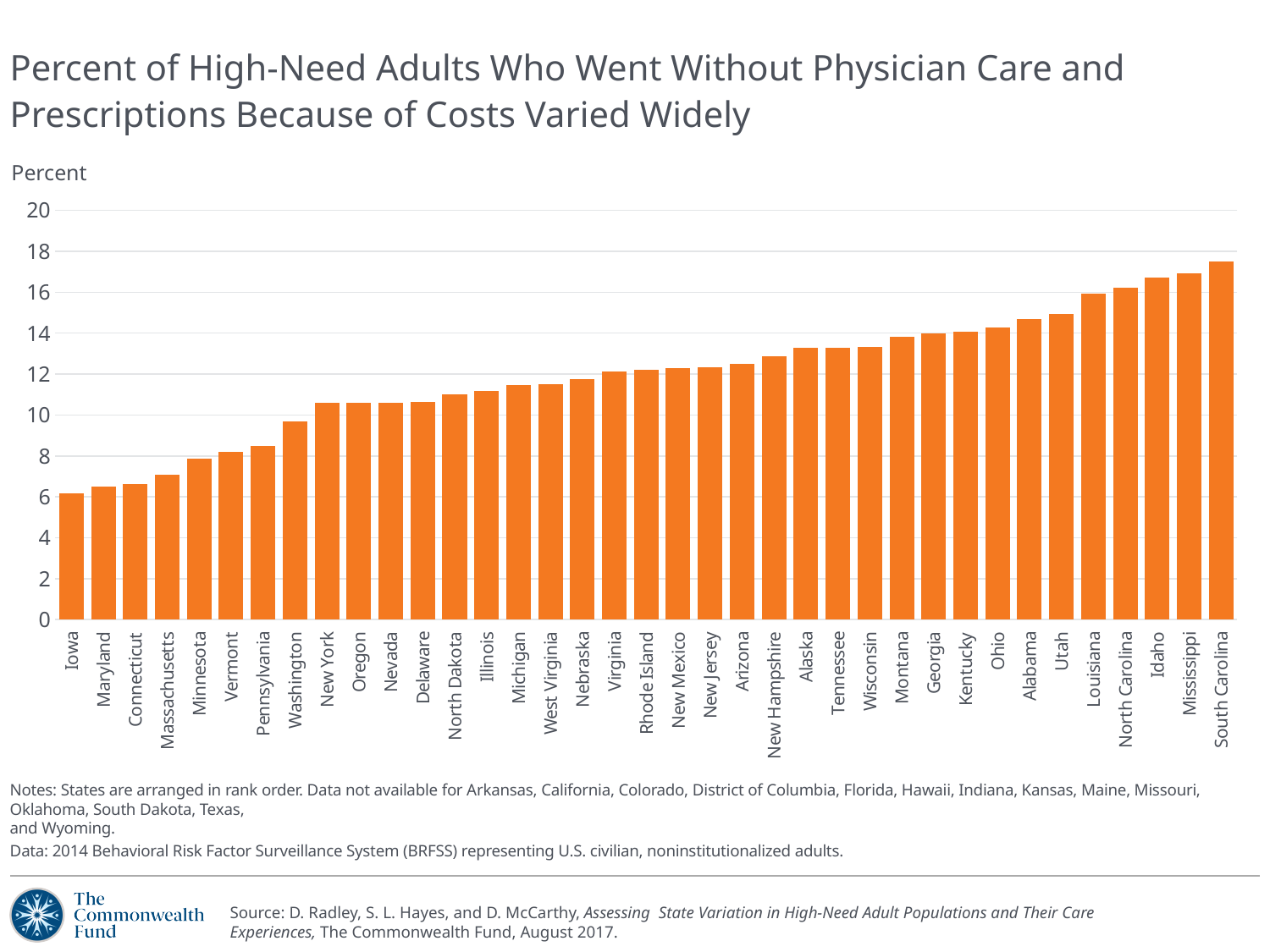
Is the value for Washington greater or less than 10? less Is the value for Iowa greater or less than 8? less Which state has the highest percent of high-need adults who went without physician care and prescriptions because of costs? South Carolina How many states are shown in the chart? 37 Is the value for New Hampshire greater or less than 12? greater Do the values rise or fall moving from left to right along the x axis? rise Which state has a higher value, Washington or Pennsylvania? Washington What kind of chart is shown on the slide? bar chart What is the label on the vertical axis of the chart? Percent Which state has a higher value, Louisiana or Alabama? Louisiana Which state has the lowest percent of high-need adults who went without physician care and prescriptions because of costs? Iowa